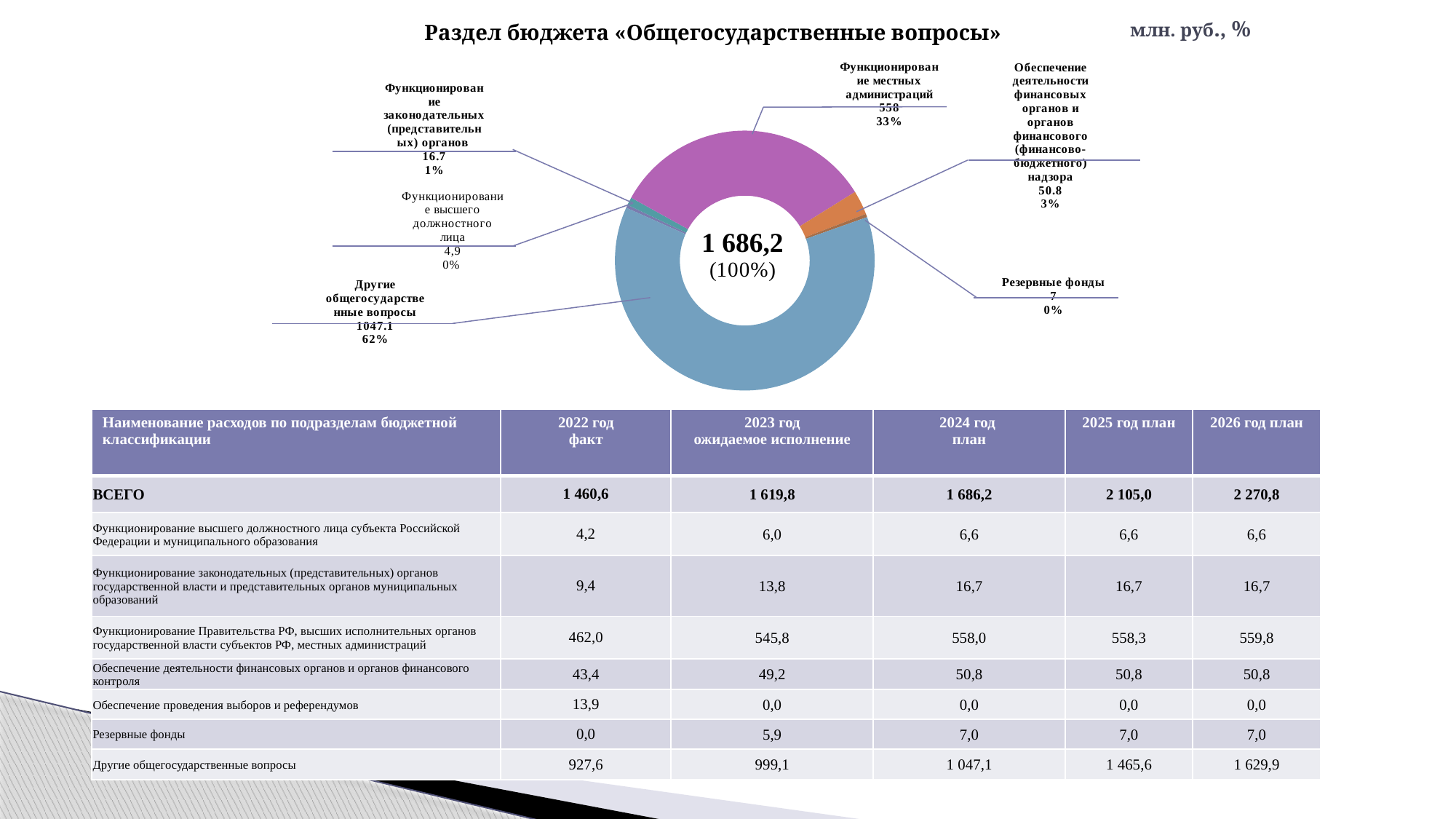
Which category has the largest slice in the donut chart? Другие общегосударственные вопросы What kind of chart is shown on the slide? Pie (donut) chart What value is shown for «Резервные фонды» in the donut chart? 7 What is the title of the chart on the slide? Раздел бюджета «Общегосударственные вопросы» How many slices does the donut chart have? 6 What share of the donut chart does «Обеспечение деятельности финансовых органов и органов финансового (финансово-бюджетного) надзора» represent? 3% What share of the donut chart does «Функционирование местных администраций» represent? 33% Which is larger in the donut chart: «Функционирование местных администраций» or «Обеспечение деятельности финансовых органов»? Функционирование местных администраций What is the total value shown in the centre of the donut chart? 1 686,2 What value is shown for «Другие общегосударственные вопросы» in the donut chart? 1047.1 What is the difference between the values for «Функционирование законодательных (представительных) органов» (16.7) and «Резервные фонды» (7) in the donut chart? 9.7 Which category has the smallest value in the donut chart? Функционирование высшего должностного лица